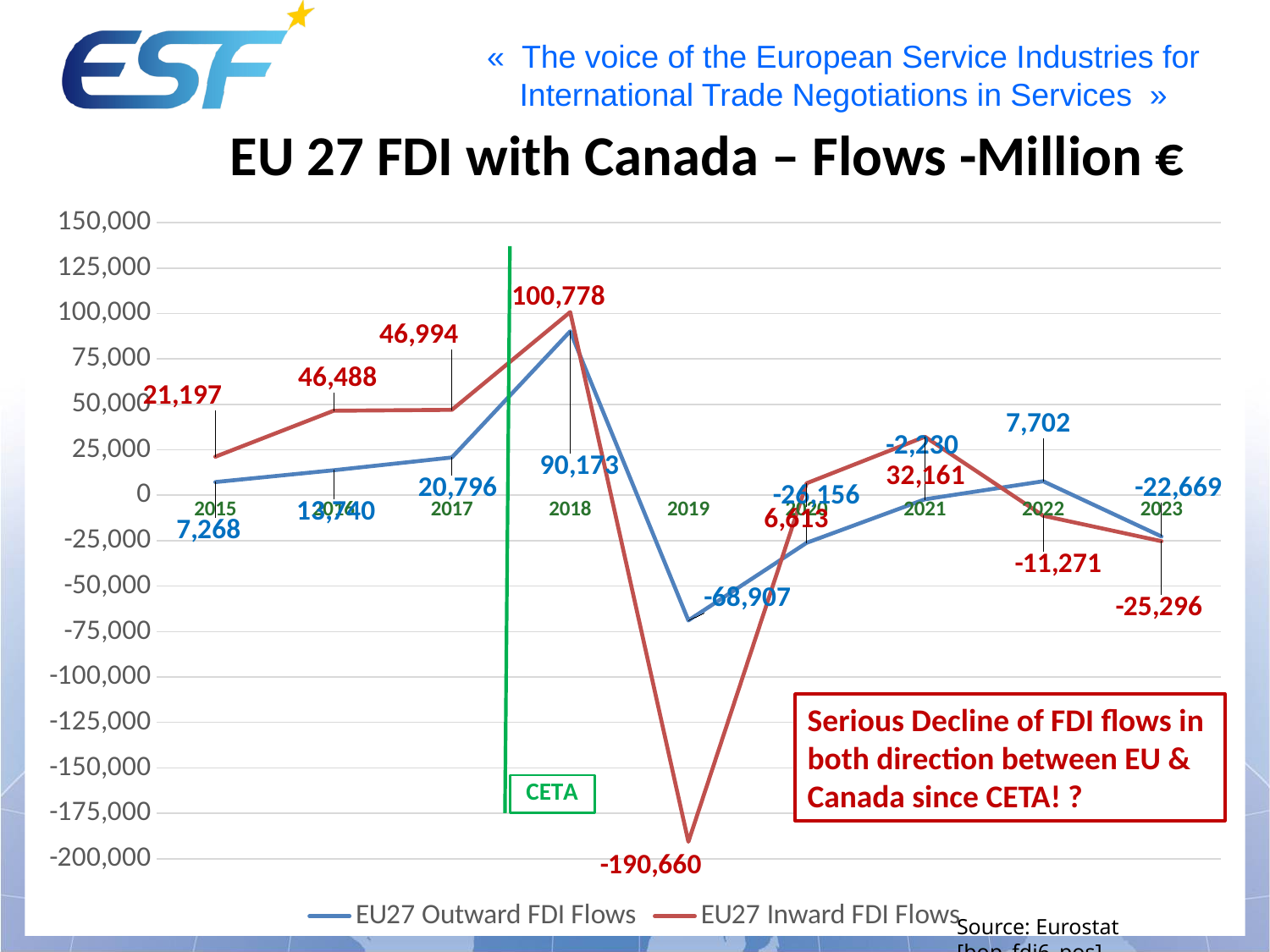
Between which two years is the green CETA marker line placed? 2017 and 2018 What was the value of EU27 Outward FDI Flows in 2023? -22,669 What kind of chart is shown on the slide? Line chart In 2018, how much larger were EU27 Inward FDI Flows than EU27 Outward FDI Flows? 10,605 What was the value of EU27 Outward FDI Flows in 2019? -68,907 What was the value of EU27 Inward FDI Flows in 2018? 100,778 In which year were EU27 Outward FDI Flows highest? 2018 What was the value of EU27 Inward FDI Flows in 2019? -190,660 In 2022, which series had the larger value: EU27 Outward FDI Flows or EU27 Inward FDI Flows? EU27 Outward FDI Flows How many years are plotted along the x axis? 9 In which year were EU27 Inward FDI Flows lowest? 2019 How many series does the legend list? 2